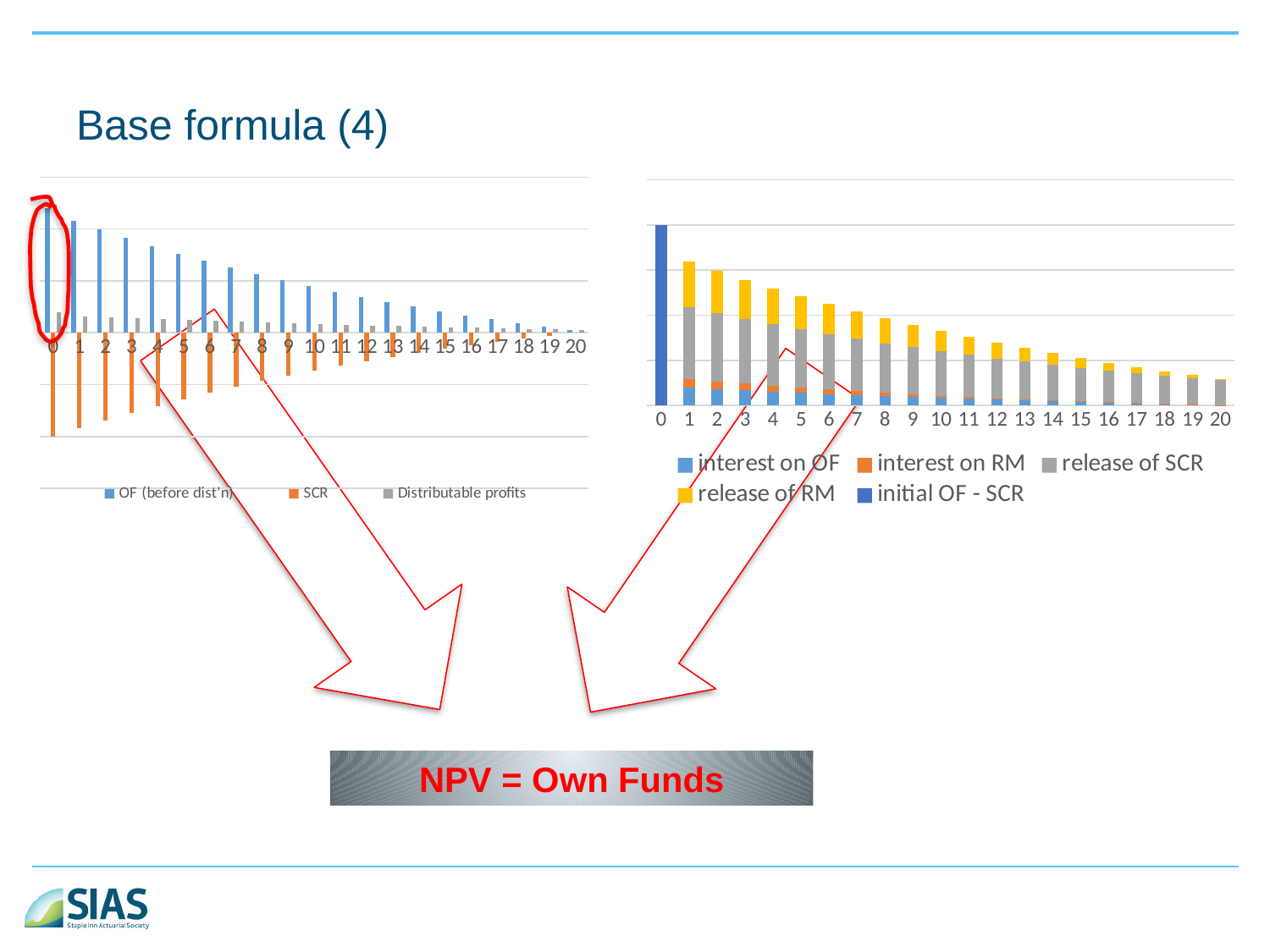
In the right chart, do the stacked bar totals rise or fall from category 1 to category 20? fall What kind of chart is the right chart (interest on OF, release of SCR, etc.)? stacked bar chart In the right chart, is the release of SCR segment at category 1 larger or smaller than the release of SCR segment at category 20? larger In the right chart, which series is the only one plotted for category 0? initial OF - SCR In the left chart, do the OF (before dist'n) values rise or fall from category 0 to category 20? fall What kind of chart is the left chart (OF (before dist'n), SCR, Distributable profits)? bar chart In the left chart, which series is plotted with negative (downward) bars? SCR How many series does the legend of the right chart list? 5 How many series does the legend of the left chart list? 3 How many categories are shown on the x axis of the right chart? 21 In the right chart, which category has the tallest bar? 0 How many categories are shown on the x axis of the left chart? 21